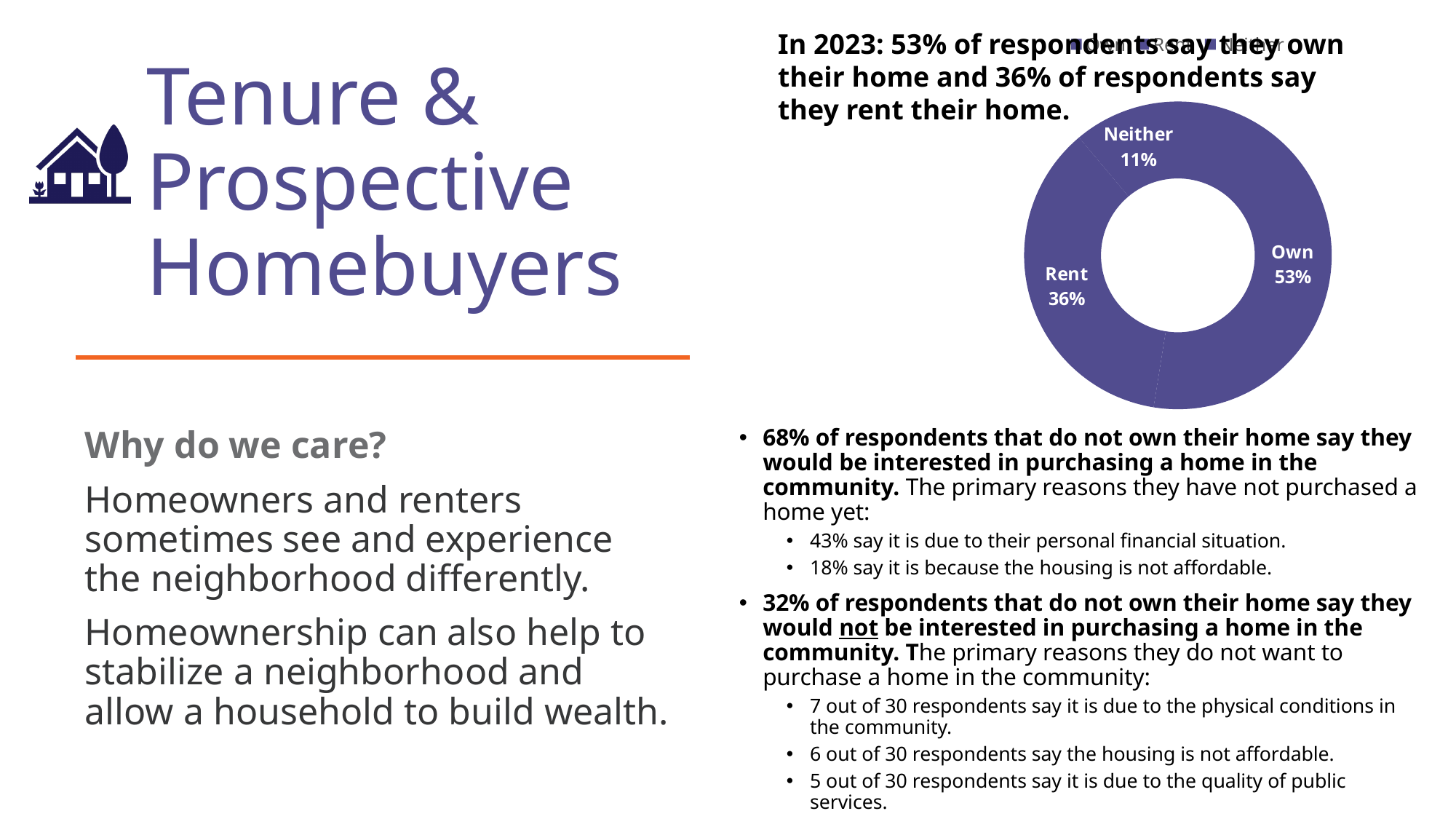
What colour are the slices of the donut chart? Purple Which category has the largest slice of the donut chart? Own Which is larger, the Rent slice or the Neither slice? Rent How many categories are shown in the donut chart? 3 Which category has the smallest slice of the donut chart? Neither What share of respondents say they own their home? 53% What is the difference in percentage points between the Own and Rent slices? 17 What percentage is shown for the Neither slice? 11% What kind of chart is shown on the slide? Donut (pie) chart What is the difference in percentage points between the Rent and Neither slices? 25 What is the combined share of respondents who own or rent their home? 89% What share of respondents say they rent their home? 36%